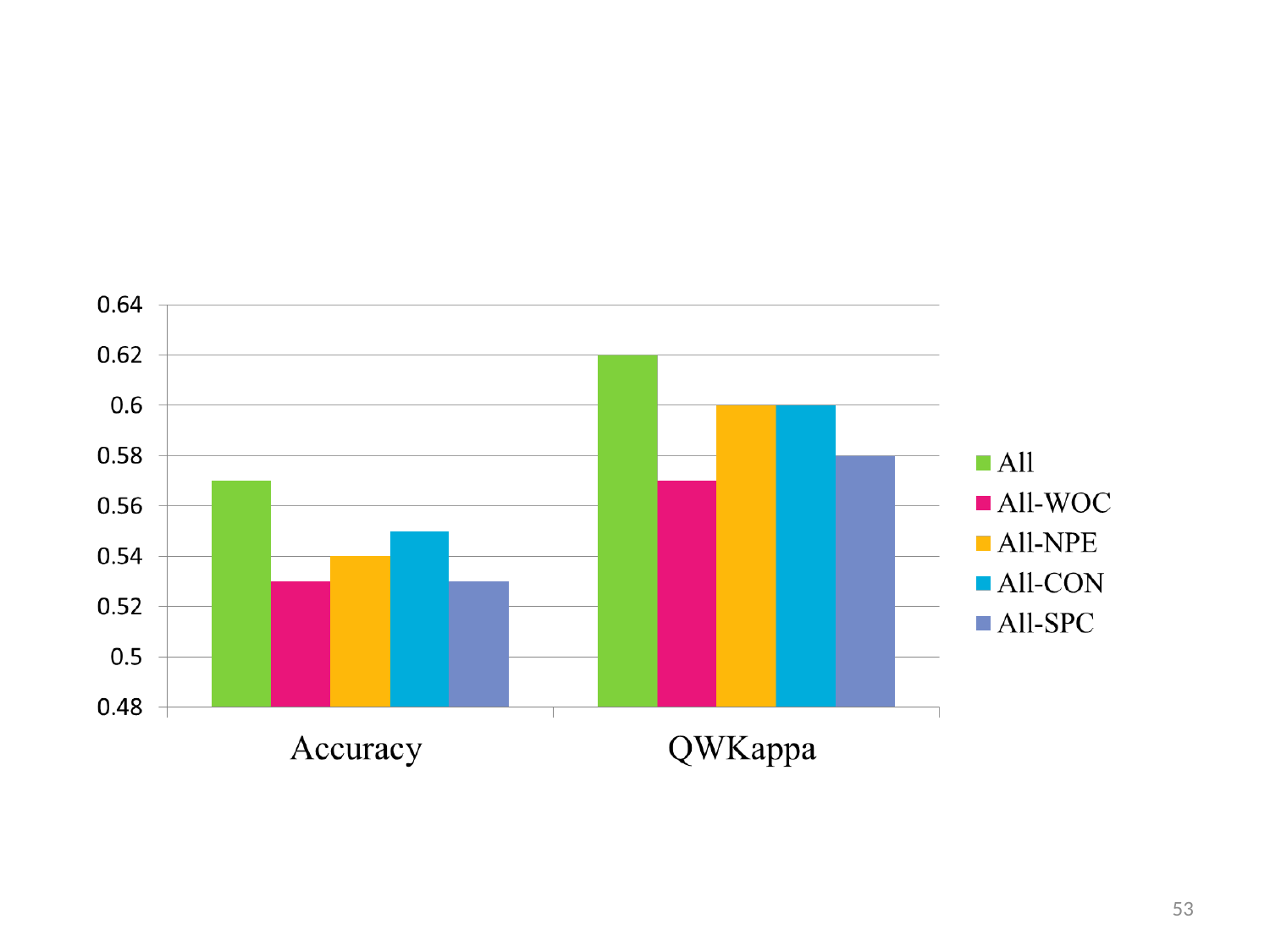
What is the QWKappa value for the All-NPE series? 0.6 How many series does the legend list? 5 Which series has the highest QWKappa value? All What is the QWKappa value for the All-SPC series? 0.58 What is the QWKappa value for the All series? 0.62 Is the Accuracy value for the All-WOC series greater or less than 0.54? less What is the Accuracy value for the All-NPE series? 0.54 Which series has the lowest QWKappa value? All-WOC What kind of chart is shown on the slide? bar chart What is the difference between the QWKappa values for All and All-SPC? 0.04 How many categories are shown on the x axis? 2 Is the Accuracy value for the All series greater or less than 0.56? greater